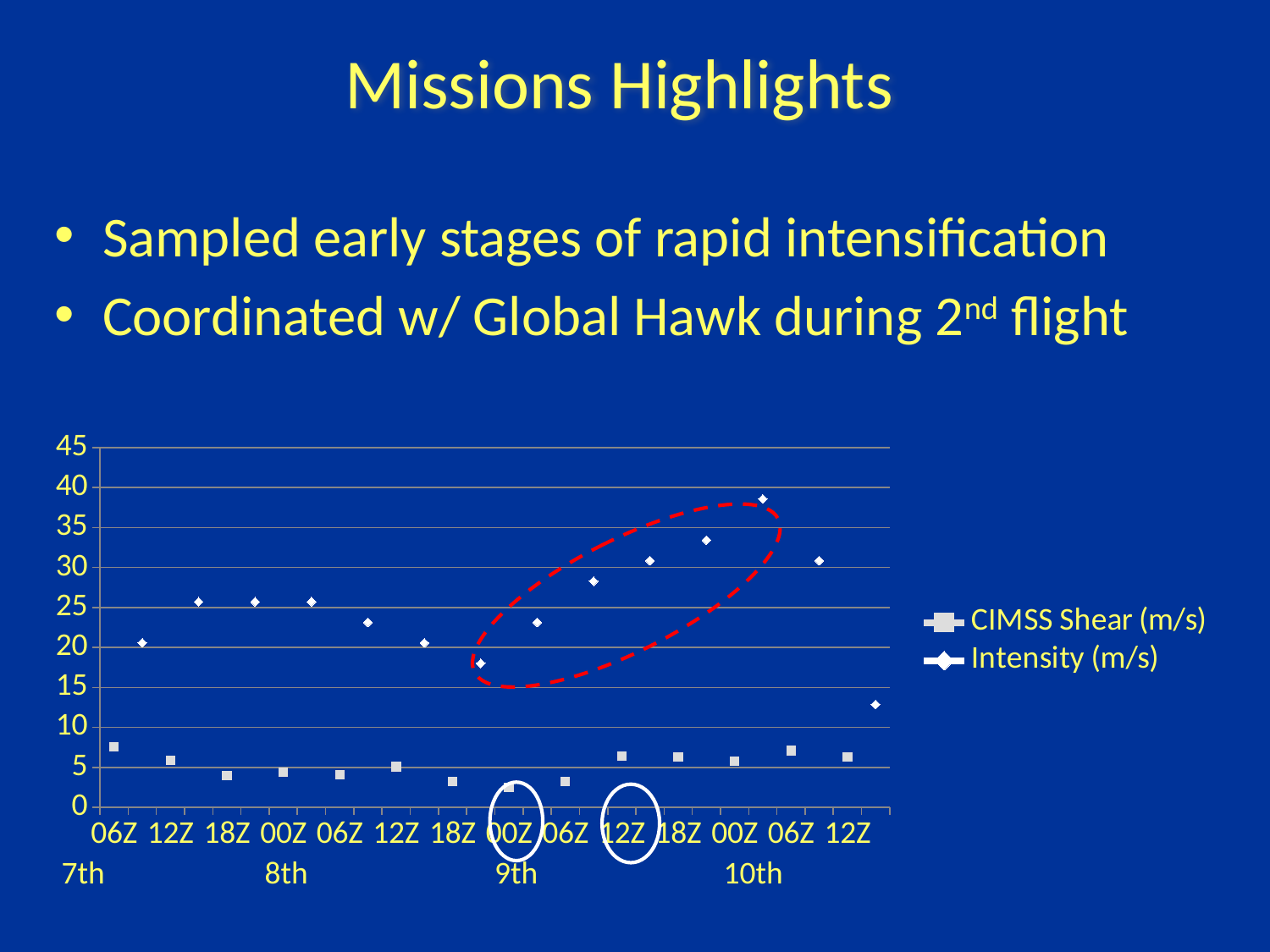
Is the Intensity (m/s) value at 00Z on the 10th greater or less than 30? greater Which is larger at 12Z on the 9th: the Intensity (m/s) value or the CIMSS Shear (m/s) value? Intensity (m/s) At which time does the Intensity (m/s) series reach its lowest value? 12Z on the 10th How many series does the chart legend list? 2 What are the two series named in the chart legend? CIMSS Shear (m/s) and Intensity (m/s) What kind of chart is shown on the slide? line chart Does the Intensity (m/s) series rise or fall from 00Z on the 9th to 06Z on the 10th? rise How many time labels are shown along the x axis of the chart? 14 Is the CIMSS Shear (m/s) value at 06Z on the 7th greater or less than 5? greater Is the Intensity (m/s) value at 06Z on the 7th greater or less than 25? less